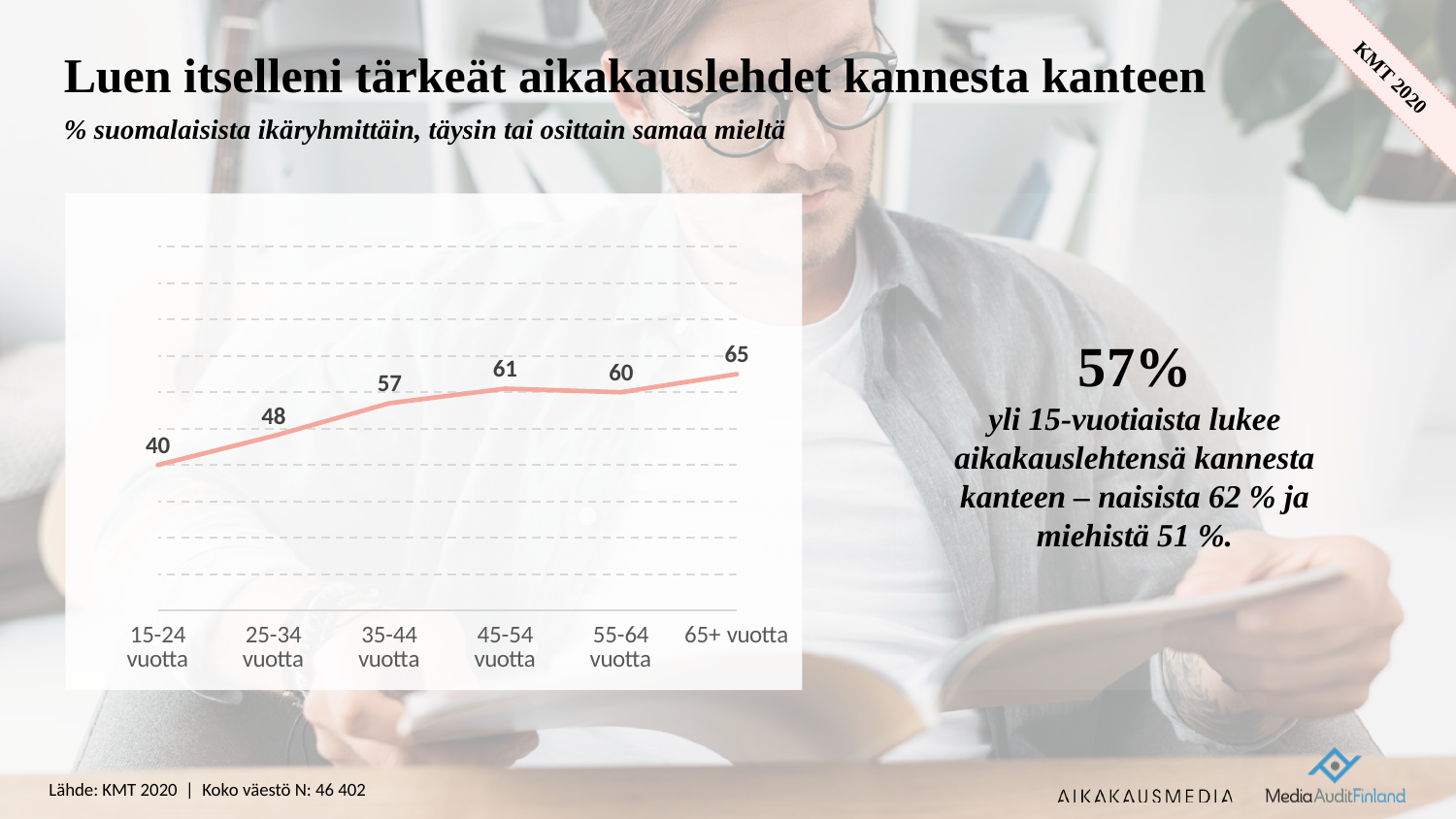
How many age groups are plotted on the chart? 6 Which has the larger value, 25-34 vuotta or 45-54 vuotta? 45-54 vuotta What is the difference between the values for 35-44 vuotta and 25-34 vuotta? 9 What is the value for the 55-64 vuotta age group? 60 What kind of chart is shown on the slide? Line chart What is the value for the 65+ vuotta age group? 65 What is the value for the 15-24 vuotta age group? 40 Do the values generally rise or fall from the youngest to the oldest age group? Rise What is the value for the 35-44 vuotta age group? 57 Which age group has the highest value? 65+ vuotta What is the difference between the values for 65+ vuotta and 15-24 vuotta? 25 Which age group has the lowest value? 15-24 vuotta